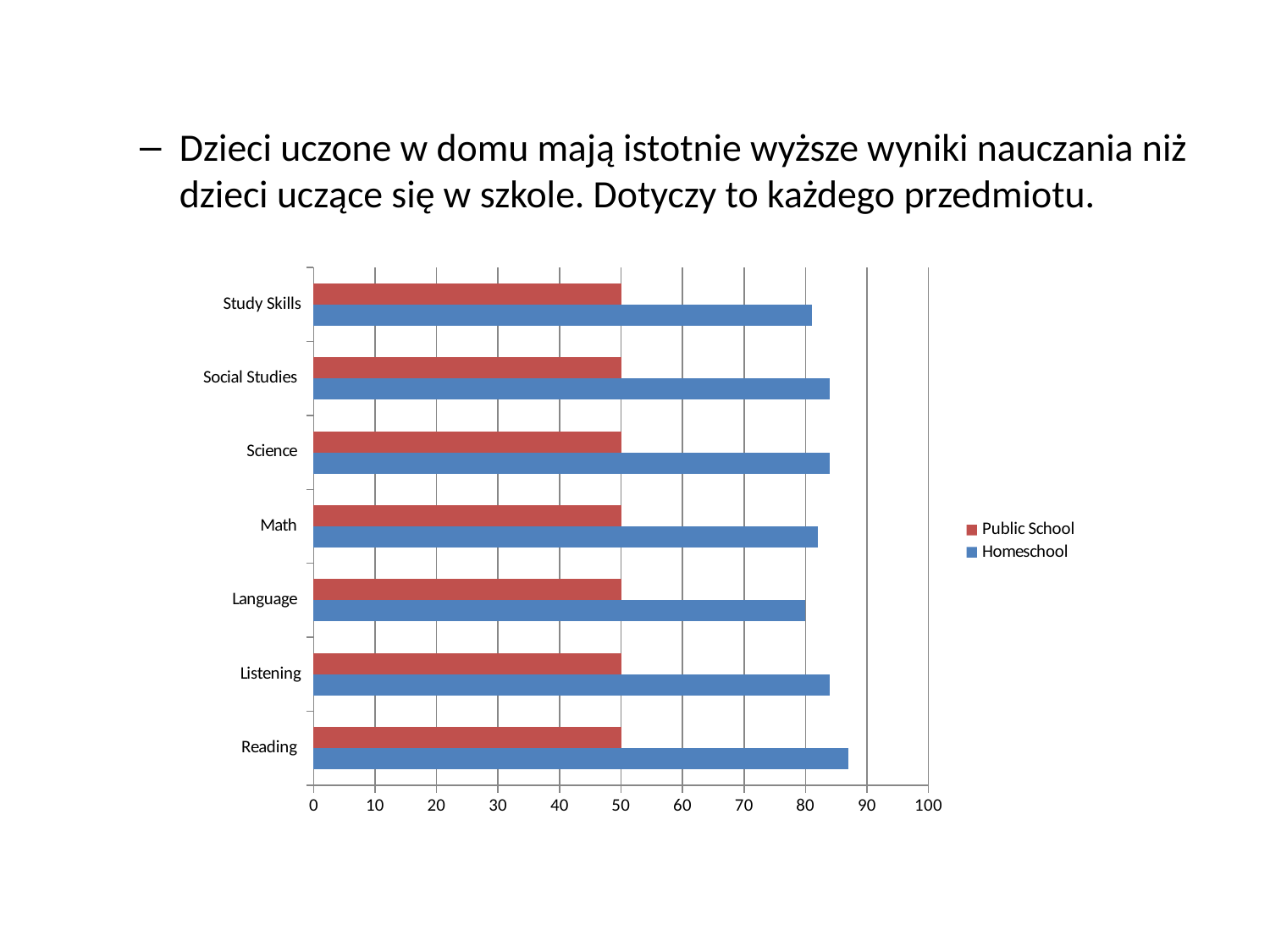
What is the Public School value for Reading? 50 How many series does the legend list? 2 Is the Homeschool value for Study Skills greater or less than 90? less What colour are the Homeschool bars? blue Is the Homeschool value for Reading greater or less than 80? greater Is the Homeschool value for Science greater or less than 80? greater Which subject has the highest Homeschool value? Reading What is the Public School value for Math? 50 What kind of chart is shown on the slide? bar chart How many subject categories are plotted on the chart? 7 For Reading, which series has the larger value, Homeschool or Public School? Homeschool Which is larger, the Homeschool value for Reading or the Homeschool value for Language? Reading